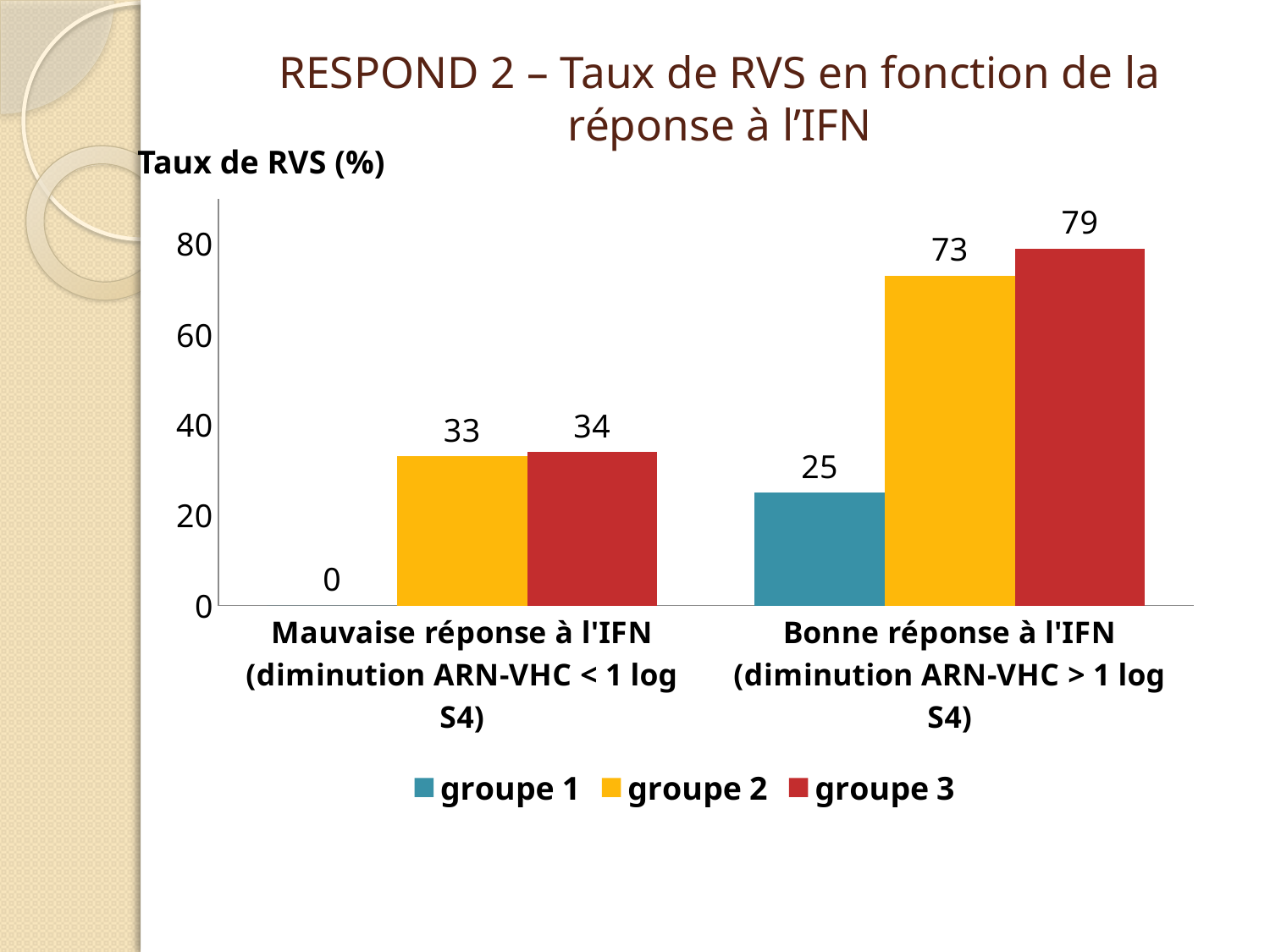
What is the label of the y axis? Taux de RVS (%) How many series does the legend list? 3 Which series has the highest value in the 'Bonne réponse à l'IFN' category? groupe 3 How many categories are shown on the x axis? 2 Which is larger: groupe 1 in 'Bonne réponse à l'IFN' or groupe 2 in 'Mauvaise réponse à l'IFN'? groupe 2 in 'Mauvaise réponse à l'IFN' What is the value for groupe 1 in the 'Mauvaise réponse à l'IFN' category? 0 Which series has the lowest value in the 'Mauvaise réponse à l'IFN' category? groupe 1 What is the difference between the groupe 2 values for 'Bonne réponse à l'IFN' and 'Mauvaise réponse à l'IFN'? 40 What is the value for groupe 1 in the 'Bonne réponse à l'IFN' category? 25 What kind of chart is shown on the slide? bar chart What is the value for groupe 2 in the 'Bonne réponse à l'IFN' category? 73 What is the value for groupe 3 in the 'Bonne réponse à l'IFN' category? 79